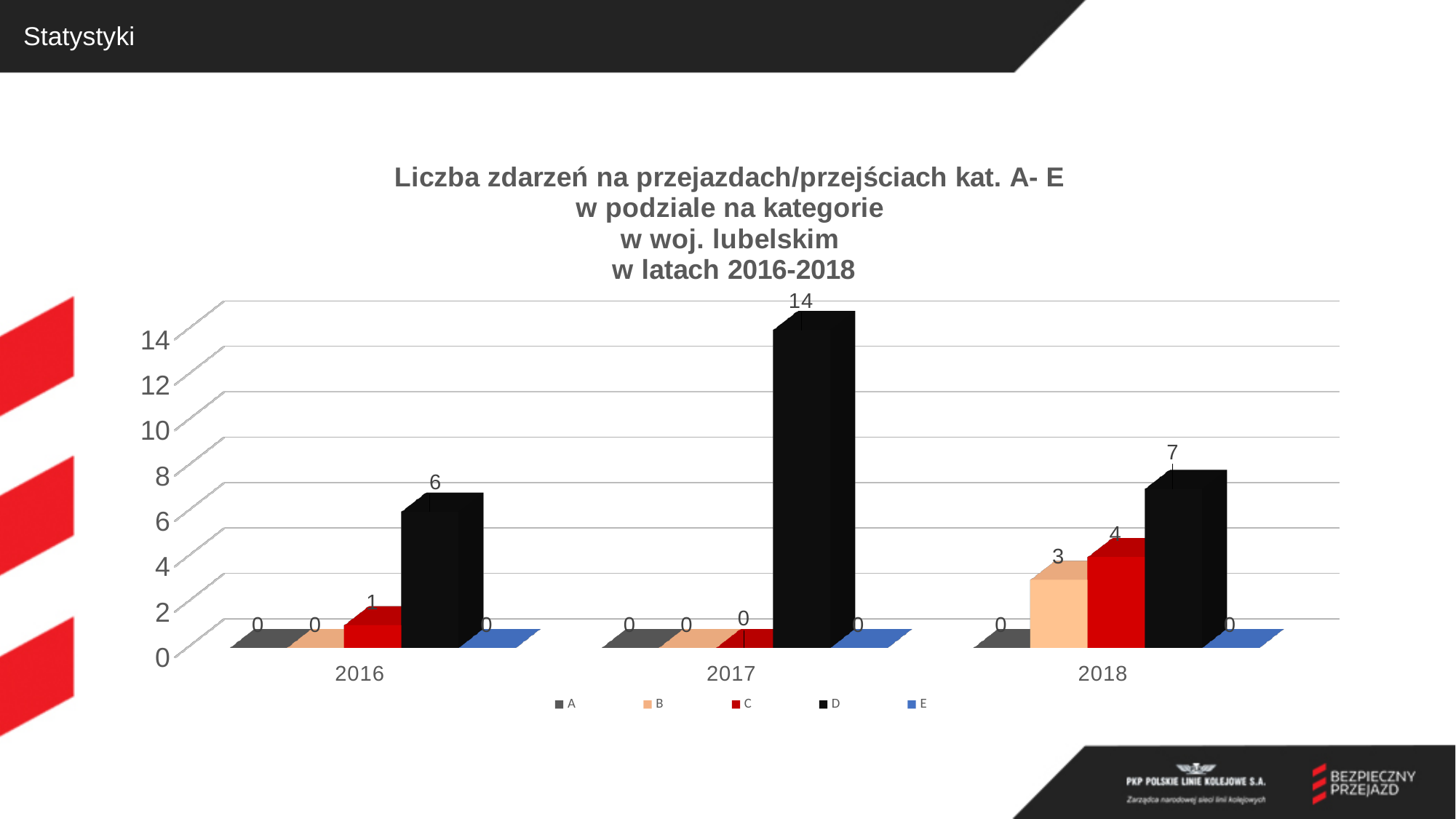
What is the value for series D in 2017? 14 What is the total of all series values for 2018? 14 What is the difference between the value for series D in 2017 and in 2018? 7 How many series does the legend list? 5 In which year is the value for series D lowest? 2016 Which is larger in 2018: the value for series B or series C? C What is the value for series C in 2018? 4 What is the value for series D in 2016? 6 What kind of chart is shown on the slide? bar chart What is the value for series B in 2018? 3 How many years are shown on the x axis? 3 In which year is the value for series D highest? 2017